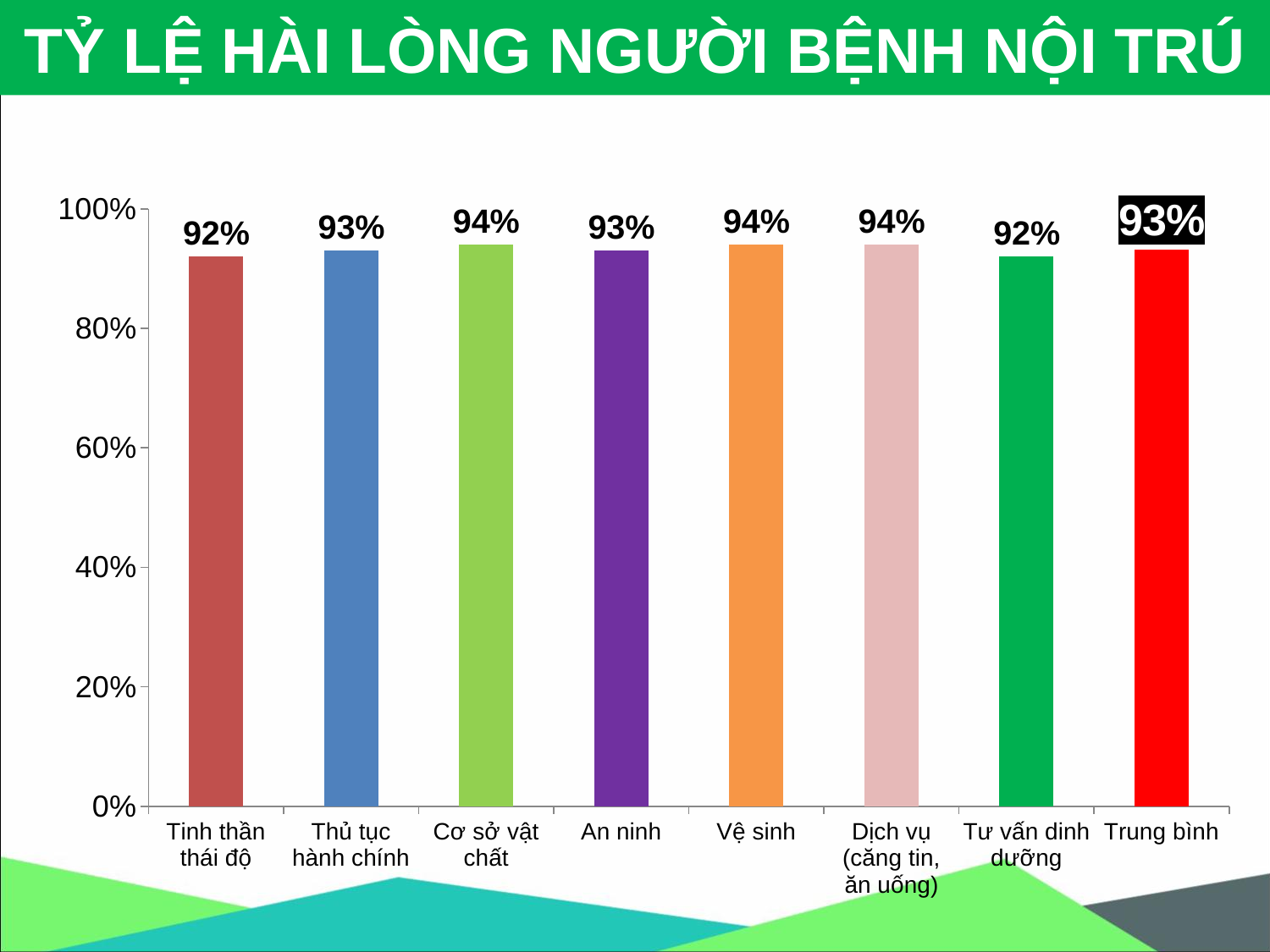
What is the value for Tư vấn dinh dưỡng? 92% How many categories are shown on the x axis? 8 What is the value for Trung bình? 93% What kind of chart is shown on the slide? bar chart What is the value for An ninh? 93% Which is larger, the value for Vệ sinh or the value for Tư vấn dinh dưỡng? Vệ sinh What is the title of the slide? TỶ LỆ HÀI LÒNG NGƯỜI BỆNH NỘI TRÚ Is the value for Thủ tục hành chính greater or less than 80%? greater What is the difference between the value for Cơ sở vật chất and the value for Tinh thần thái độ? 2% What is the value for Tinh thần thái độ? 92% What is the value for Cơ sở vật chất? 94% What is the value for Dịch vụ (căng tin, ăn uống)? 94%